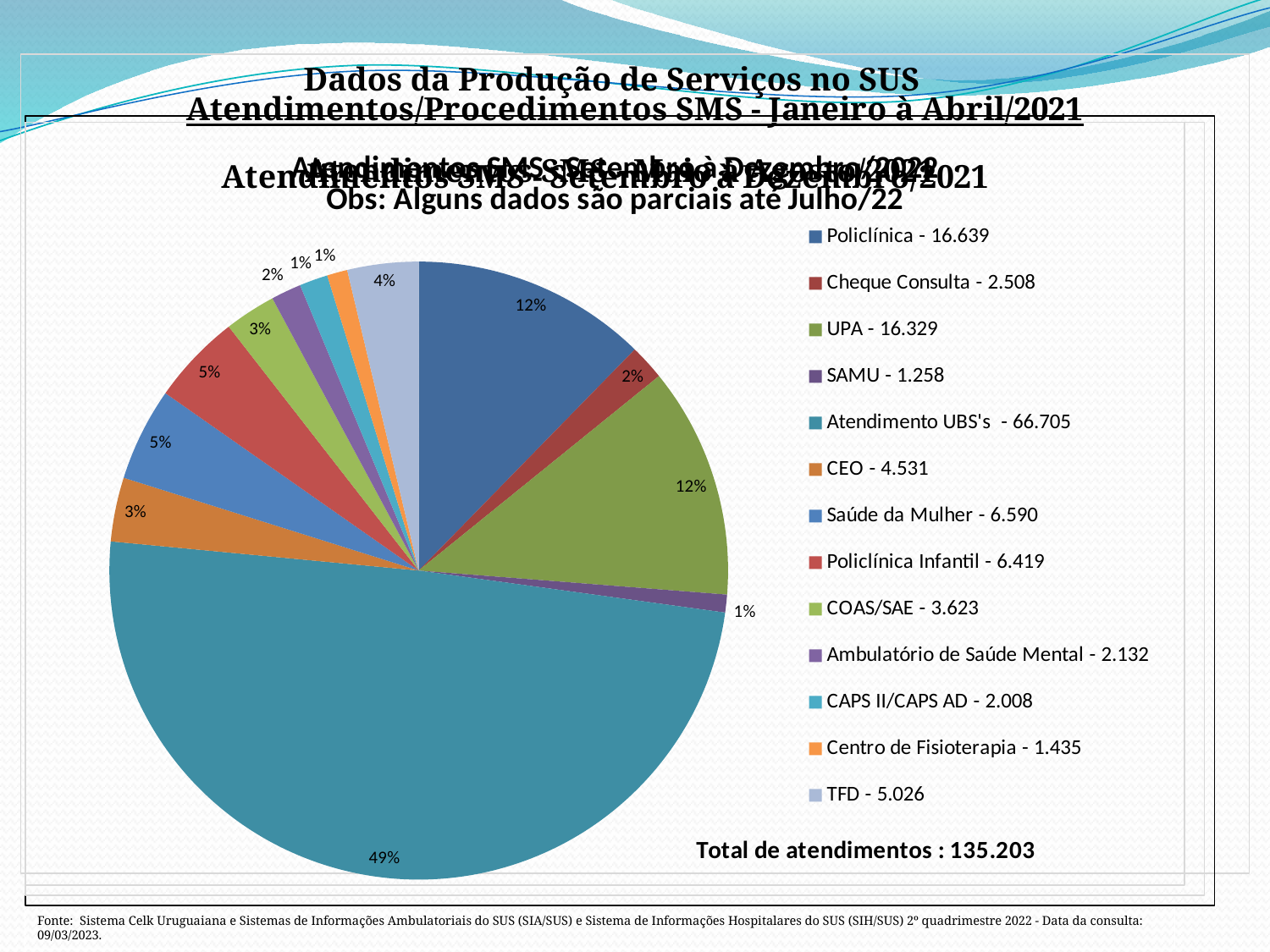
What value is shown for Policlínica in the legend? 16.639 What total number of atendimentos is stated on the slide? 135.203 What value is shown for Saúde da Mulher in the legend? 6.590 How many slices does the pie chart have? 13 What percentage share does UPA have in the pie chart? 12% What value is shown for CEO in the legend? 4.531 What kind of chart is shown on the slide? pie chart What percentage share does Atendimento UBS's have in the pie chart? 49% What is the difference between the values for Policlínica (16.639) and UPA (16.329)? 310 What percentage share does TFD have in the pie chart? 4% Which category has the largest share of the pie? Atendimento UBS's Which is larger, the value for Atendimento UBS's or the value for Policlínica? Atendimento UBS's